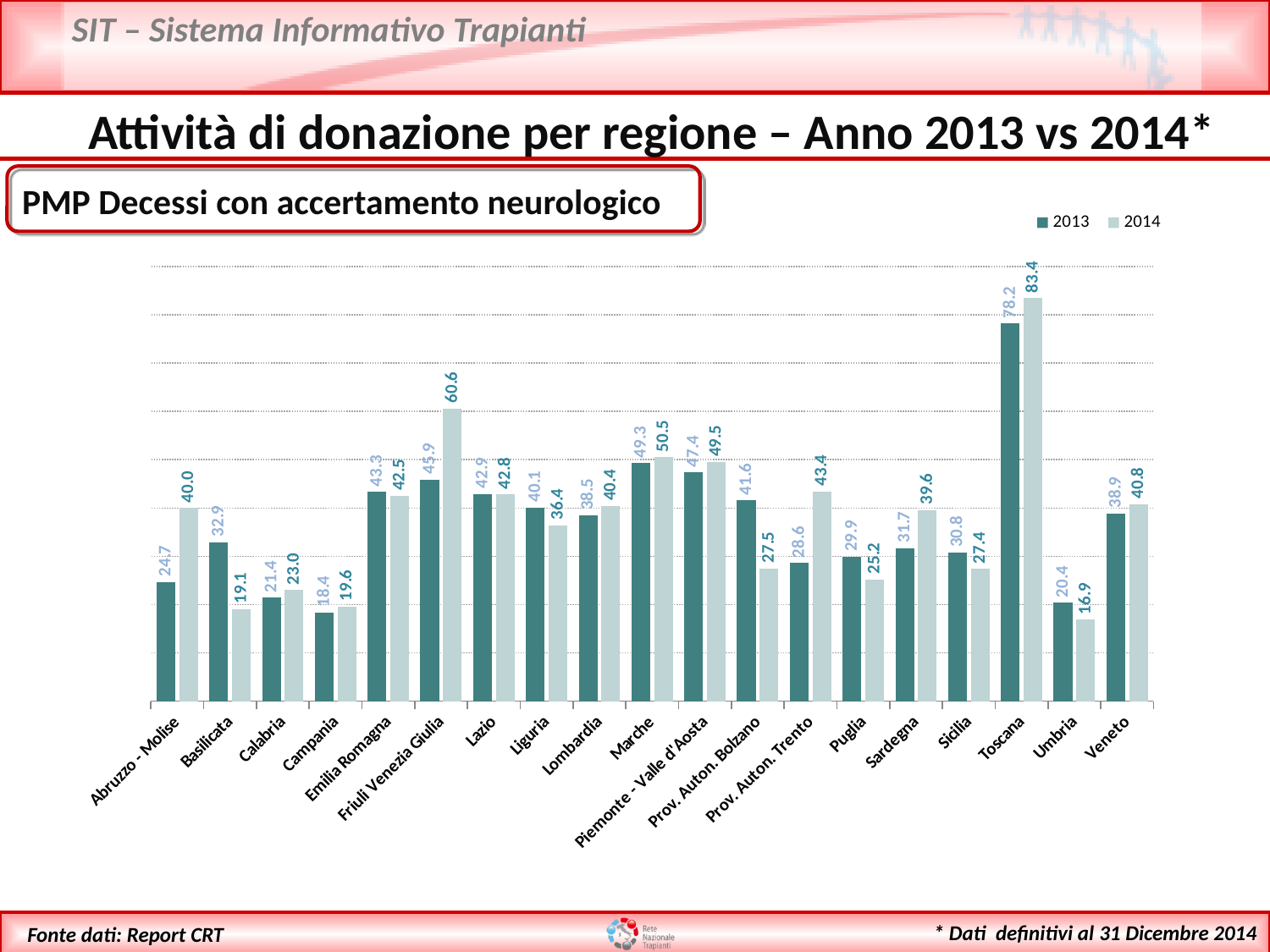
Which region has the highest 2014 value? Toscana What is the 2013 value for Abruzzo - Molise? 24.7 What is the difference between the 2014 and 2013 values for Toscana? 5.2 What is the 2014 value for Toscana? 83.4 Which region has the lowest 2014 value? Umbria What is the 2013 value for Prov. Auton. Bolzano? 41.6 Which region has the lowest 2013 value? Campania How many series does the legend list? 2 What is the difference between the 2014 and 2013 values for Abruzzo - Molise? 15.3 What is the 2014 value for Friuli Venezia Giulia? 60.6 How many regions are shown on the x axis? 19 For Basilicata, which year has the larger value, 2013 or 2014? 2013